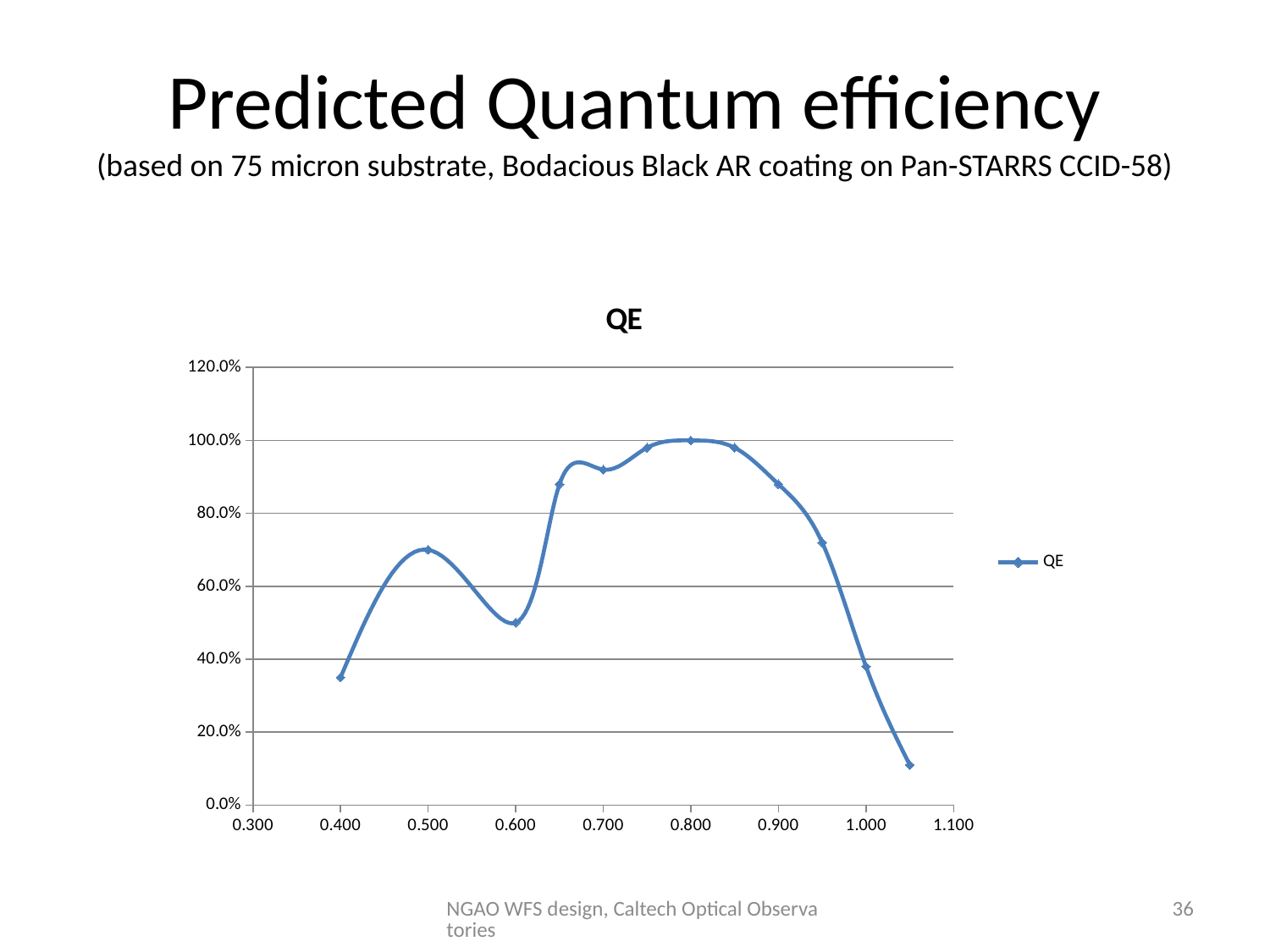
At which x value does the QE line reach its highest point? 0.800 Is the QE value at x = 0.400 greater or less than 40.0%? less How many data points are plotted on the QE line? 12 Do the QE values rise or fall as x increases from 0.800 to 1.050? fall What is the QE value at x = 0.800? 100.0% How many series does the legend list? 1 What kind of chart is shown on the slide? line chart Is the QE value at x = 1.050 greater or less than 20.0%? less Is the QE value at x = 0.650 greater or less than 80.0%? greater What is the title of the chart? QE Which has the larger QE value, x = 0.500 or x = 0.600? 0.500